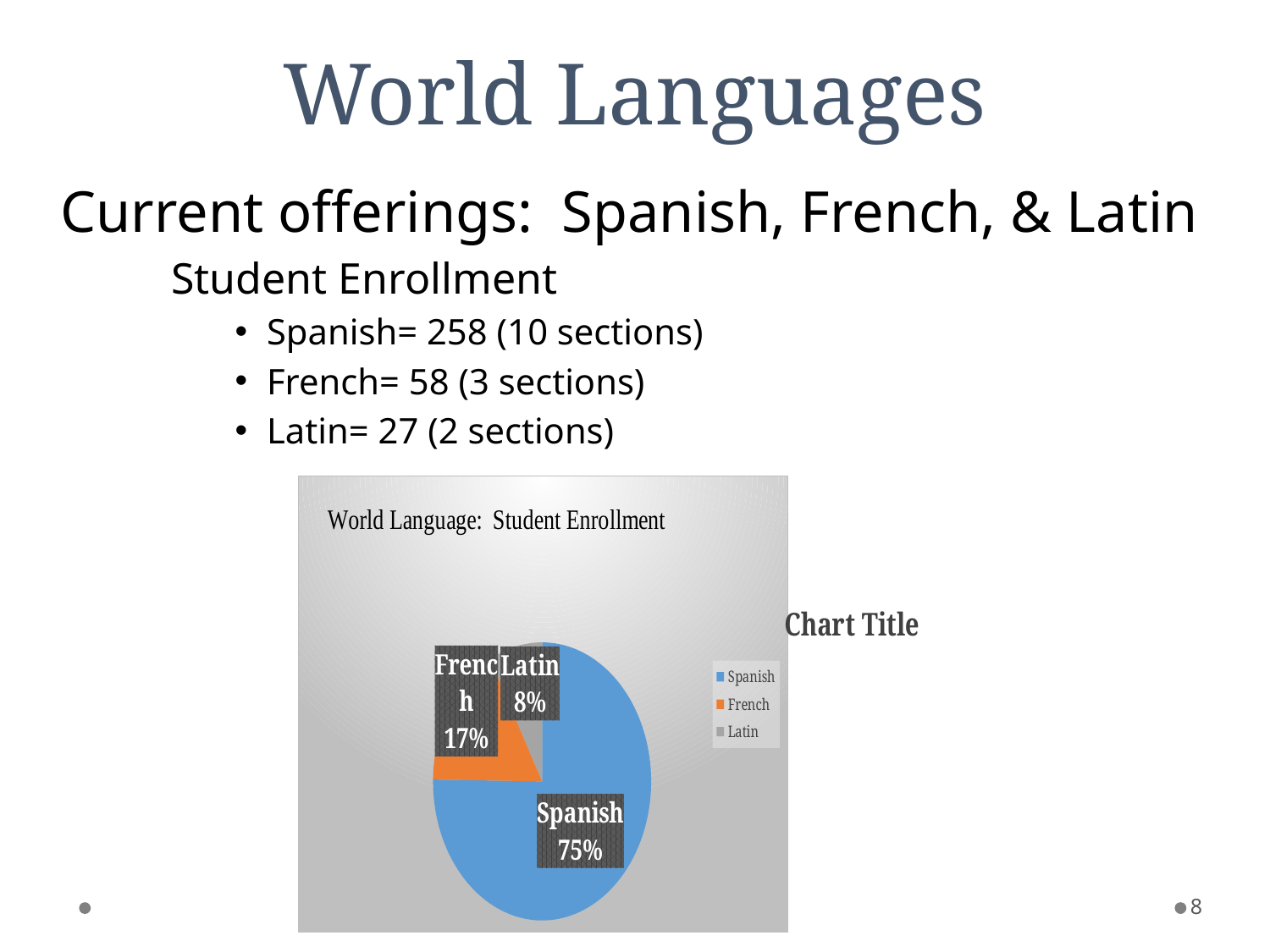
Which language has the largest slice of the pie? Spanish What share of the pie does French represent? 17% What colour is the Spanish slice of the pie? Blue What is the difference in percentage points between the Spanish and French slices? 58 How many slices does the pie chart have? 3 What is the title shown inside the chart area? World Language: Student Enrollment Which language has the smallest slice of the pie? Latin What share of the pie does Latin represent? 8% Which slice is larger, French or Latin? French How many entries does the chart legend list? 3 What share of the pie does Spanish represent? 75% What kind of chart is shown on the slide? Pie chart